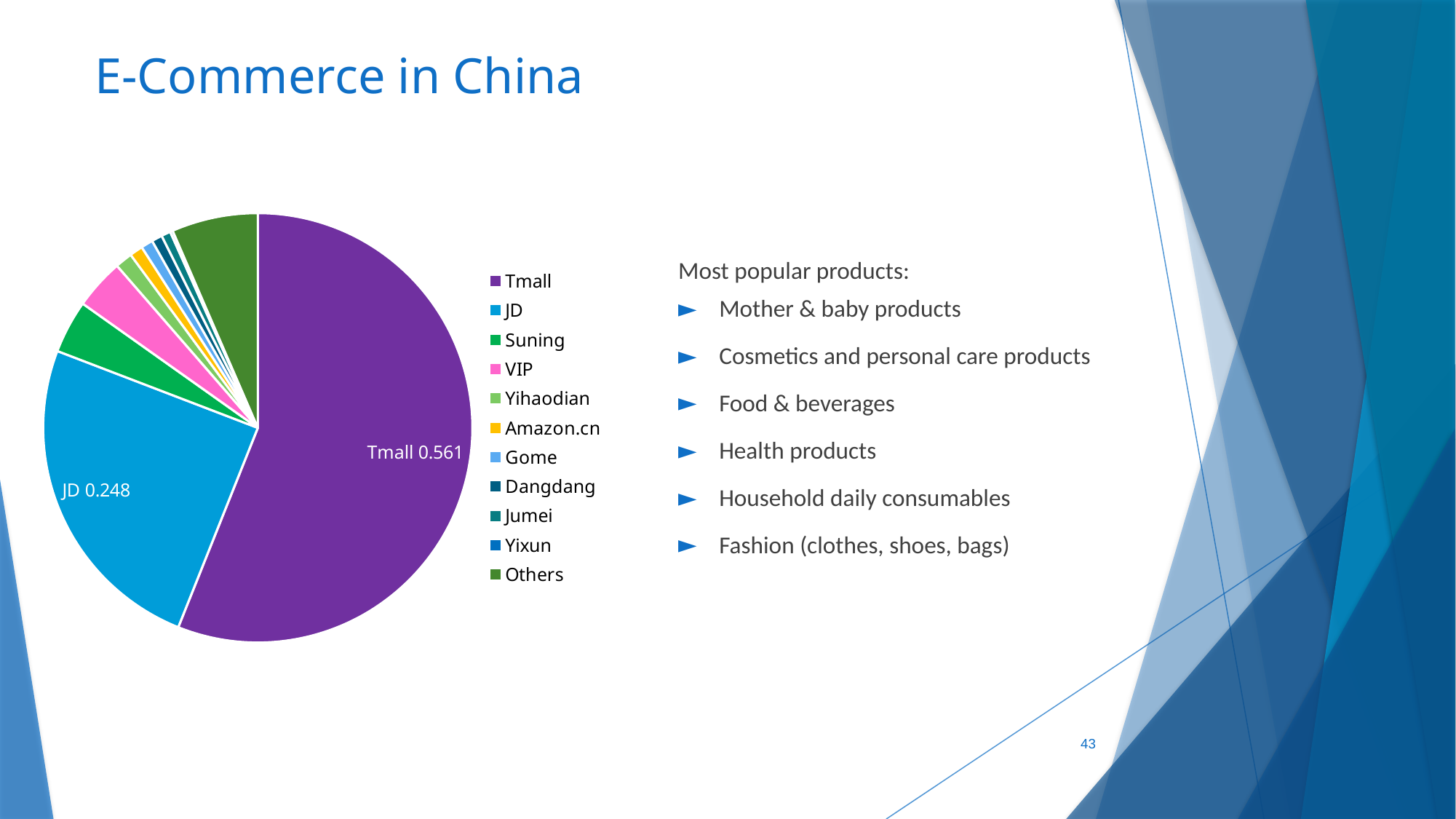
Which legend entry appears last in the pie chart's legend? Others What is the difference between the Tmall value and the JD value in the pie chart? 0.313 Which is larger in the pie chart, Tmall or JD? Tmall Which is larger in the pie chart, JD or Suning? JD What share of the pie does Tmall account for? 0.561 What colour is the Tmall slice in the pie chart? purple What value is shown for JD in the pie chart? 0.248 Which is larger in the pie chart, Others or Suning? Others Which category has the largest slice in the pie chart? Tmall What value is shown for Tmall in the pie chart? 0.561 What type of chart is shown on the slide? pie chart How many categories does the pie chart's legend list? 11